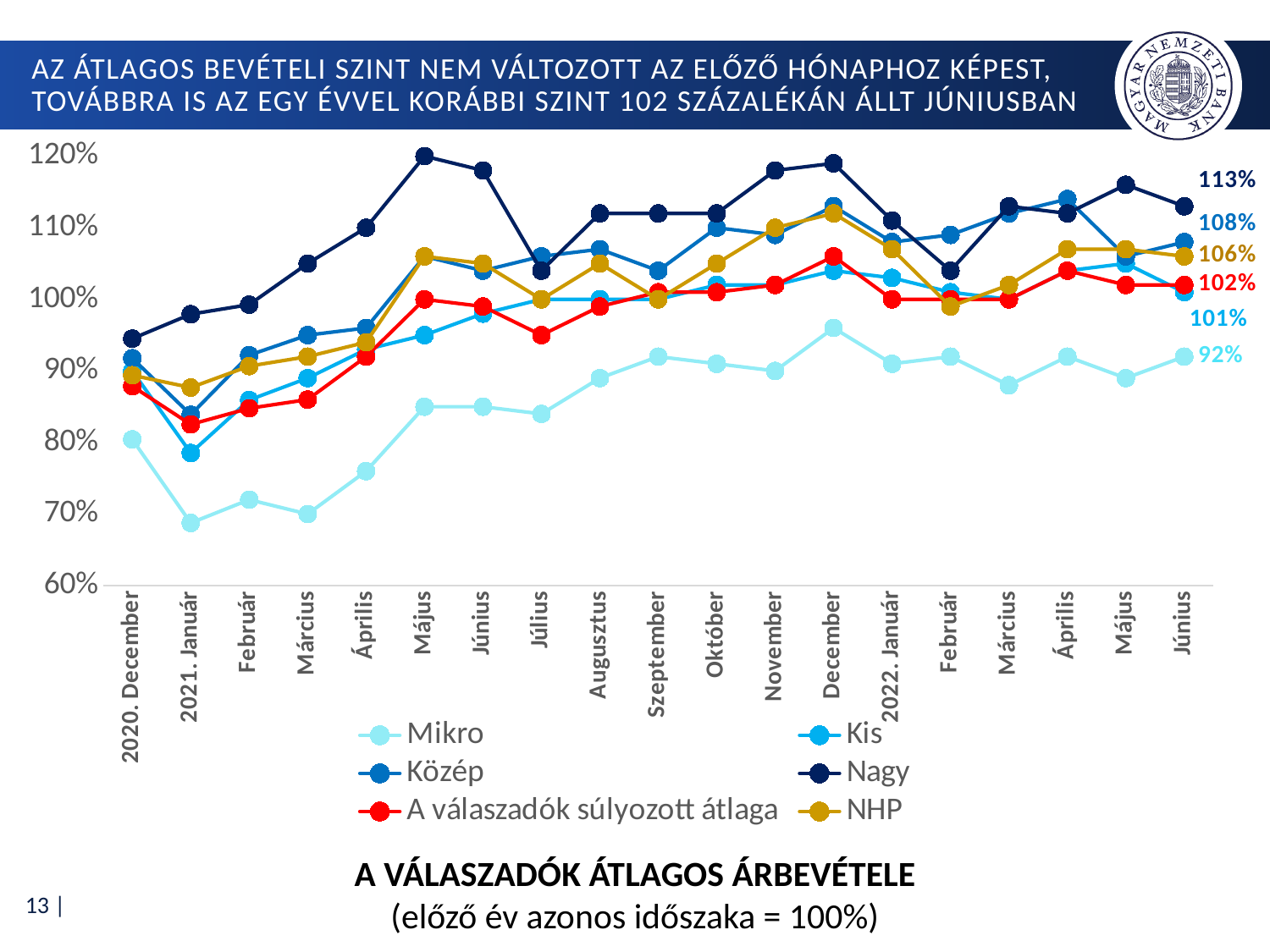
What is the difference between the Nagy and Mikro values in 2022 Június? 21 percentage points Is the value of the Mikro series in 2021. Január greater or less than 70%? less In 2022 Június, which is larger: the Közép value or the Kis value? Közép Which series has the highest value in 2022 Június? Nagy What is the value of the Mikro series in 2022 Június? 92% What is the value of the Nagy series in 2022 Június? 113% What is the value of 'A válaszadók súlyozott átlaga' in 2022 Június? 102% What is the value of the NHP series in 2022 Június? 106% Which series has the lowest value in 2022 Június? Mikro What kind of chart is shown on the slide? line chart How many series does the legend list? 6 Does the Mikro series rise or fall from 2020. December to 2021. Január? fall